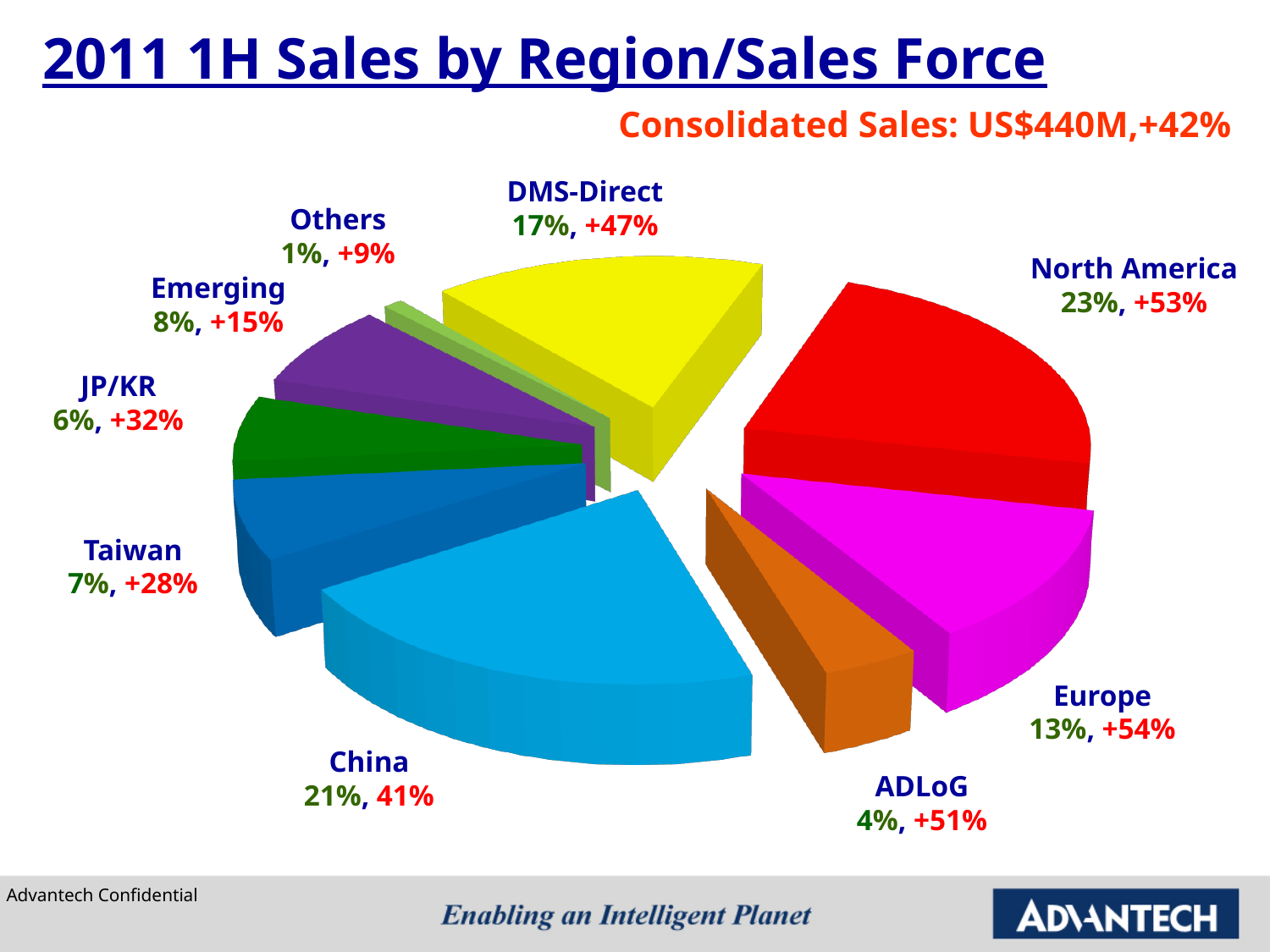
What is the difference in share between North America and Europe? 10% What share of sales does China account for? 21% What share of sales does North America account for? 23% How many slices does the pie chart have? 9 Which has a larger share of sales, Taiwan or JP/KR? Taiwan What kind of chart is shown on the slide? Pie chart What is the growth rate shown for ADLoG? +51% What is the growth rate shown for Europe? +54% What consolidated sales figure is stated on the slide? US$440M,+42% Which region or sales force has the largest share of sales? North America What share of sales does DMS-Direct account for? 17% Which region or sales force has the smallest share of sales? Others